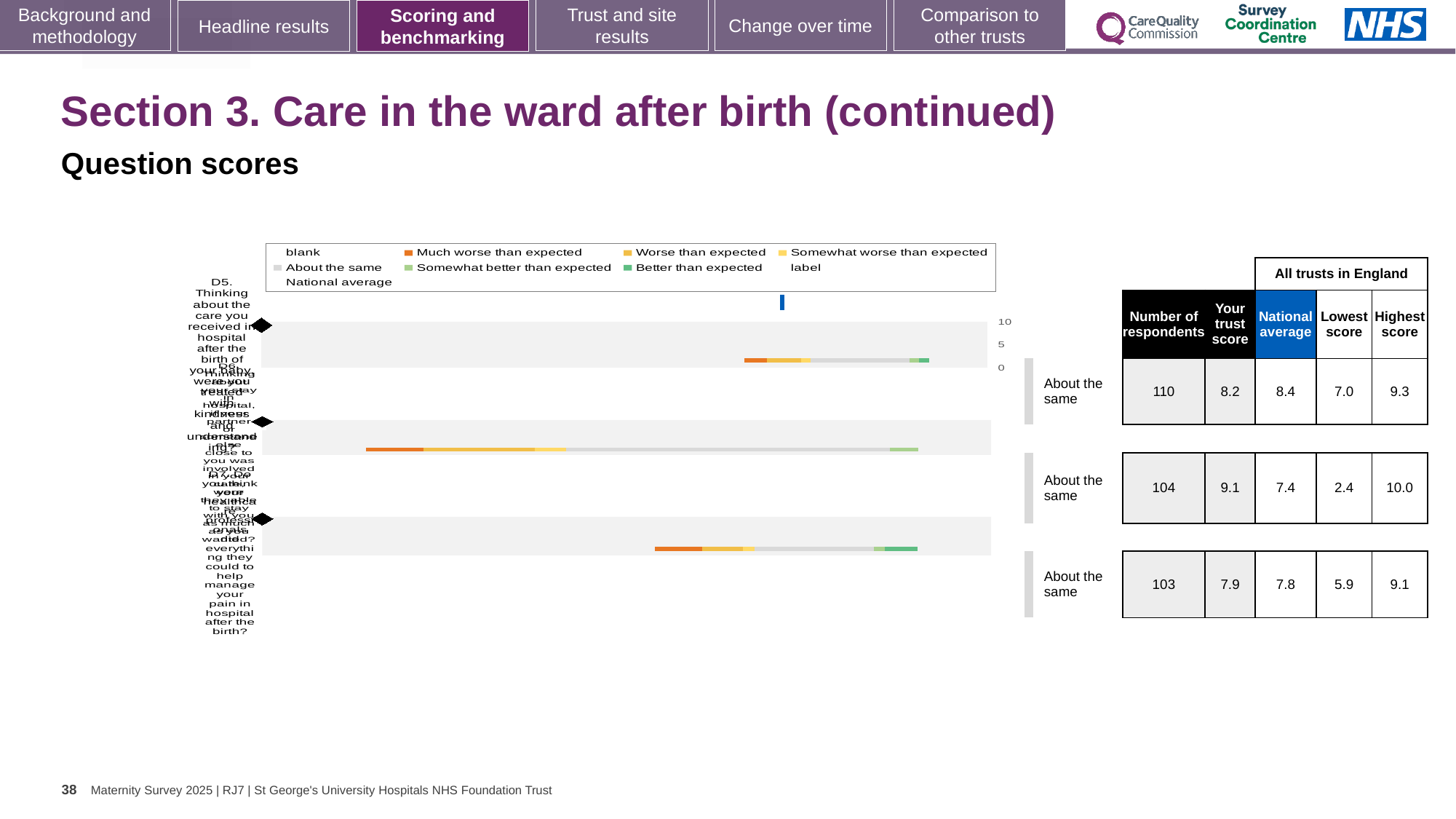
For the third row, which is larger: 'Your trust score' or the national average? Your trust score (7.9) What benchmark category is shown for each of the three rows? About the same In the table next to the chart, what is 'Your trust score' for the second row? 9.1 For the first row, what is the difference between the national average (8.4) and 'Your trust score' (8.2)? 0.2 How many question rows (bars) does the chart show? 3 Which row has the highest 'Your trust score' in the table next to the chart? the second row (9.1) Which row has the lowest 'Lowest score' in the table next to the chart? the second row (2.4) What kind of chart is shown on the slide? bar chart In the table next to the chart, what is the number of respondents for the first row? 110 In the table next to the chart, what is the national average for the third row? 7.8 In the table next to the chart, what is the highest score for the second row? 10.0 What colour represents 'Much worse than expected' in the chart legend? orange